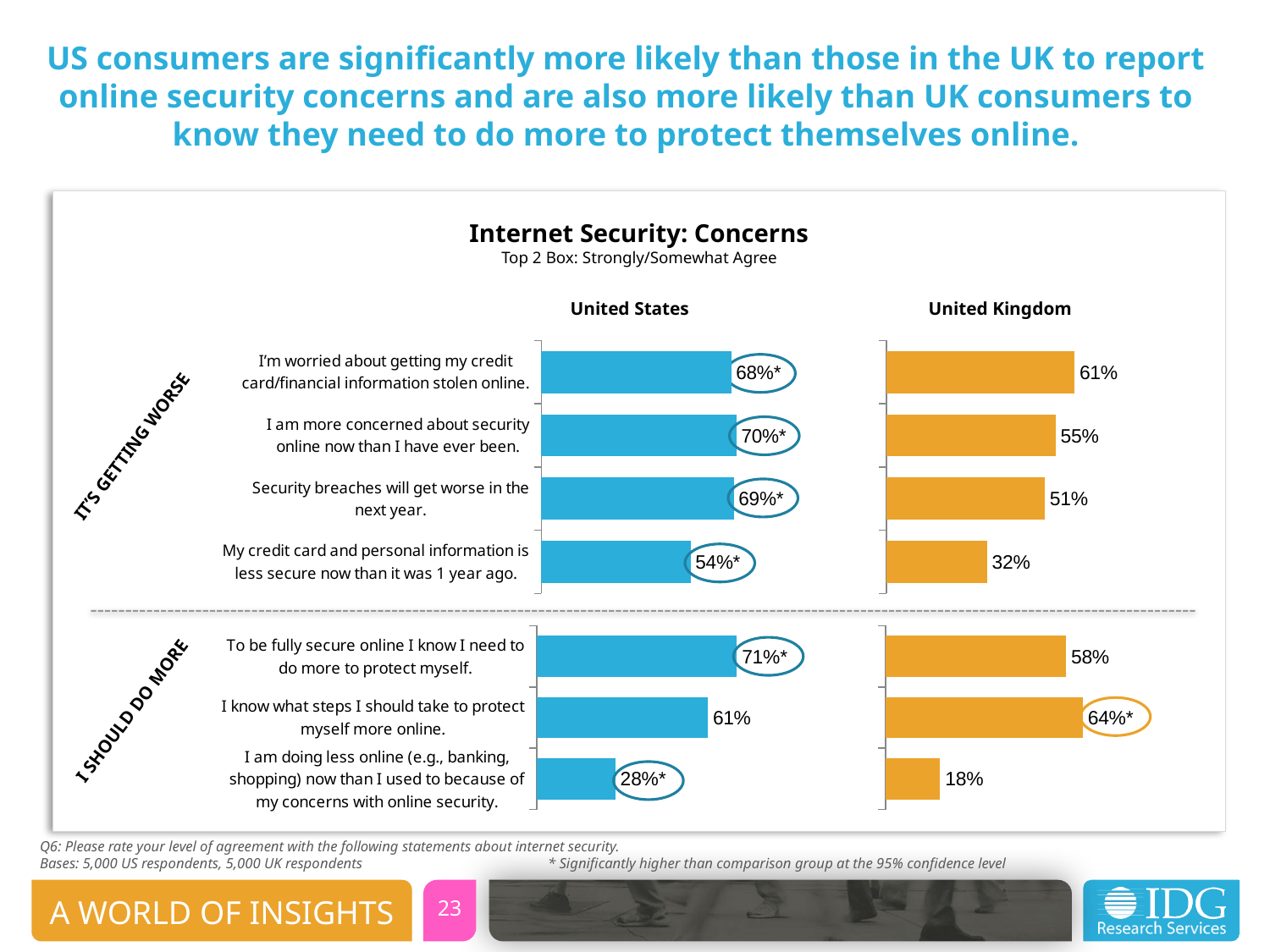
In the Internet Security: Concerns chart, what is the United States value for "I'm worried about getting my credit card/financial information stolen online"? 68%* In the Internet Security: Concerns chart, what colour are the United Kingdom bars? Orange In the Internet Security: Concerns chart, which statement has the lowest United Kingdom value? I am doing less online (e.g., banking, shopping) now than I used to because of my concerns with online security. In the Internet Security: Concerns chart, what is the difference between the United States and United Kingdom values for "My credit card and personal information is less secure now than it was 1 year ago"? 22 percentage points In the Internet Security: Concerns chart, what is the United Kingdom value for "Security breaches will get worse in the next year"? 51% In the Internet Security: Concerns chart, how many statements are plotted? 7 In the Internet Security: Concerns chart, which is larger for "I know what steps I should take to protect myself more online": the United States value or the United Kingdom value? United Kingdom In the Internet Security: Concerns chart, what is the United Kingdom value for "I know what steps I should take to protect myself more online"? 64%* What kind of chart is the Internet Security: Concerns chart? Bar chart In the Internet Security: Concerns chart, which statement has the highest United Kingdom value? I know what steps I should take to protect myself more online. In the Internet Security: Concerns chart, which statement has the highest United States value? To be fully secure online I know I need to do more to protect myself. In the Internet Security: Concerns chart, what is the difference between the United States and United Kingdom values for "I am more concerned about security online now than I have ever been"? 15 percentage points